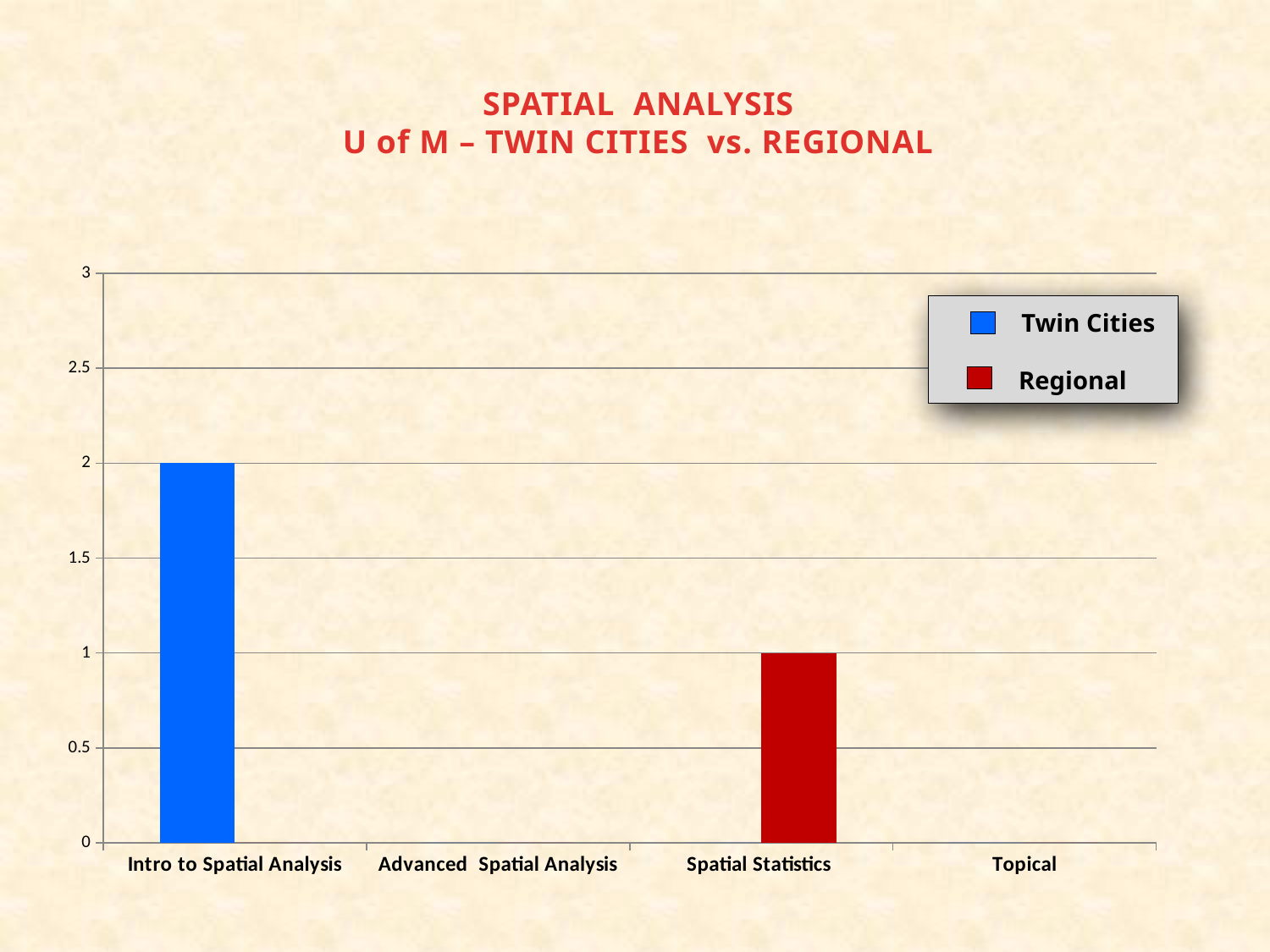
What is the difference between the Twin Cities value for Intro to Spatial Analysis and the Regional value for Spatial Statistics? 1 What is the Twin Cities value for Intro to Spatial Analysis? 2 How many categories are shown on the x axis? 4 Is the Twin Cities value for Intro to Spatial Analysis greater or less than 1.5? greater How many series does the legend list? 2 Which series is shown in red in the legend? Regional Which is larger: the Twin Cities bar for Intro to Spatial Analysis or the Regional bar for Spatial Statistics? Twin Cities bar for Intro to Spatial Analysis Which category has the highest bar on the chart? Intro to Spatial Analysis What is the Regional value for Spatial Statistics? 1 Is the Regional value for Spatial Statistics greater or less than 2? less What type of chart is shown on the slide? Bar chart What is the title of the chart? SPATIAL ANALYSIS U of M – TWIN CITIES vs. REGIONAL